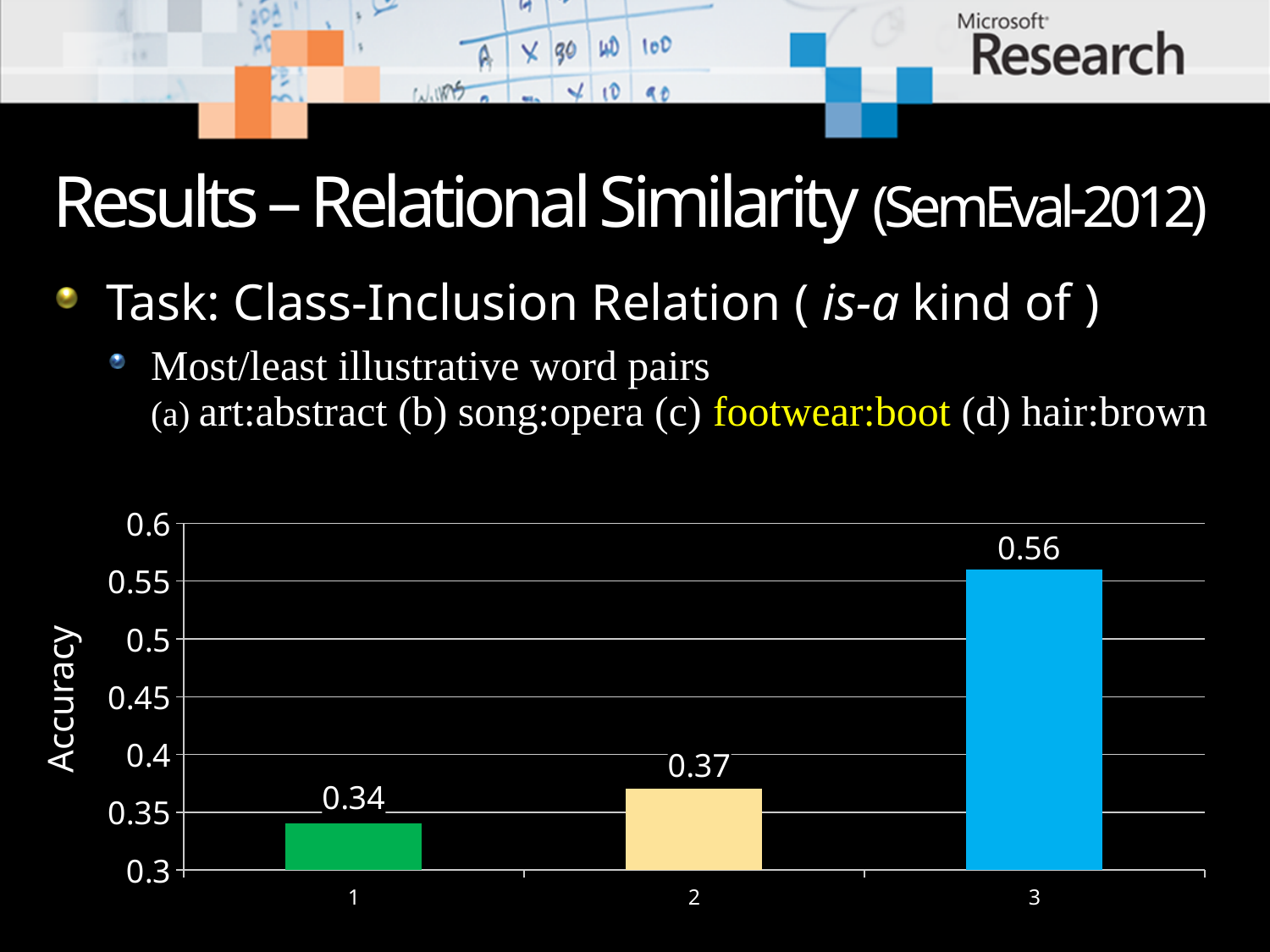
What is the label of the vertical axis of the chart? Accuracy What is the accuracy value for category 3? 0.56 Is the accuracy for category 3 greater or less than 0.5? greater What kind of chart is shown on the slide? bar chart What is the accuracy value for category 1? 0.34 What is the accuracy value for category 2? 0.37 Which has a higher accuracy, category 2 or category 3? 3 What is the difference in accuracy between category 3 and category 1? 0.22 What is the difference in accuracy between category 2 and category 1? 0.03 Which category has the lowest accuracy? 1 How many bars are shown in the chart? 3 Which category has the highest accuracy? 3